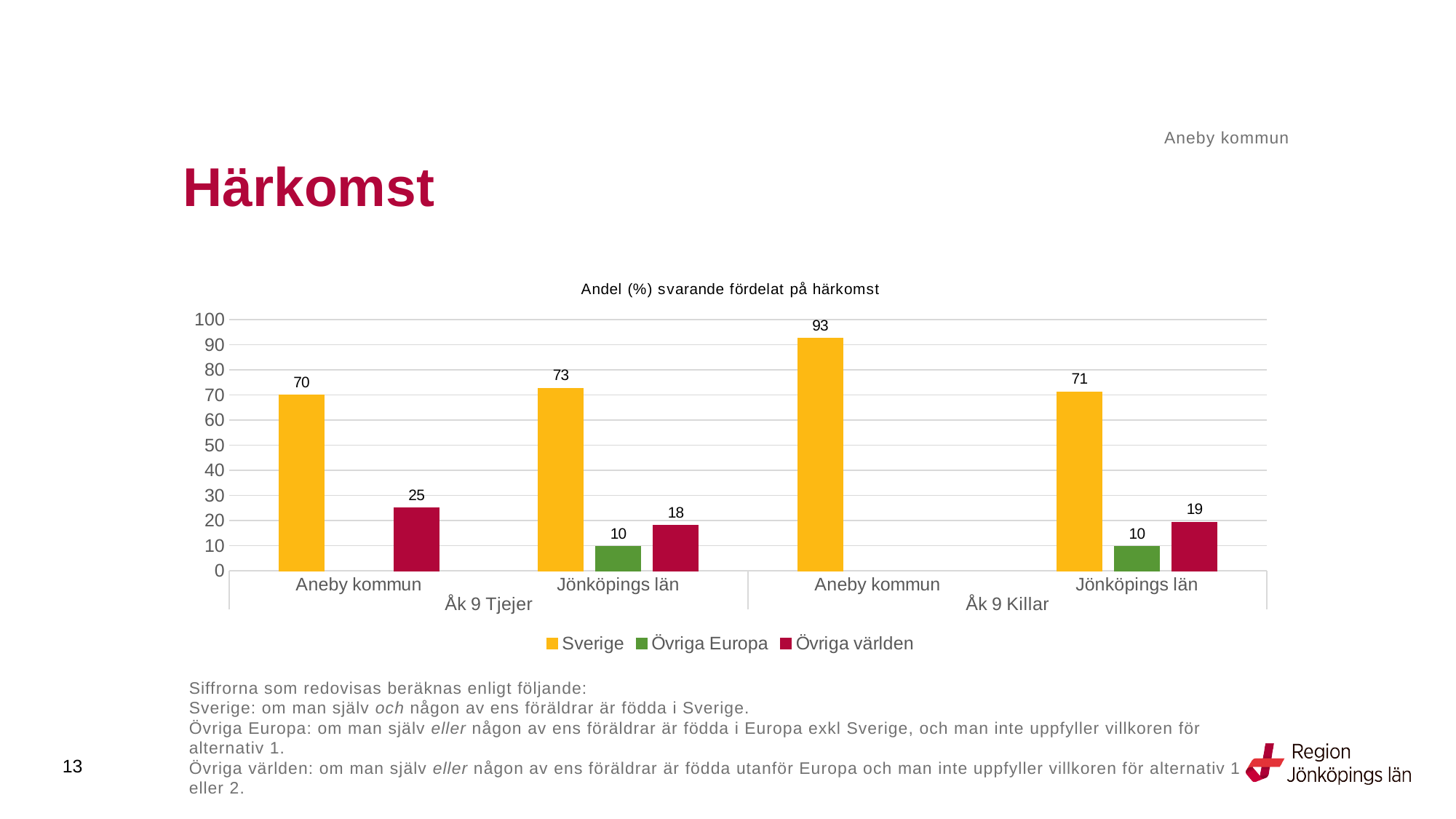
What is the value for Sverige for Aneby kommun among Åk 9 Tjejer? 70 What is the value for Övriga Europa for Jönköpings län among Åk 9 Tjejer? 10 How many series does the legend list? 3 Which group has the highest Sverige value? Aneby kommun, Åk 9 Killar What is the value for Övriga världen for Jönköpings län among Åk 9 Killar? 19 Which colour represents Övriga Europa in the chart? green What is the difference between the Sverige values for Aneby kommun among Åk 9 Killar and Åk 9 Tjejer? 23 What kind of chart is shown on the slide? bar chart Which is larger: Övriga världen for Aneby kommun among Åk 9 Tjejer or Övriga världen for Jönköpings län among Åk 9 Tjejer? Aneby kommun, Åk 9 Tjejer What is the title of the chart? Andel (%) svarande fördelat på härkomst What is the value for Sverige for Aneby kommun among Åk 9 Killar? 93 Is the Sverige value for Jönköpings län among Åk 9 Killar greater or less than 80? less